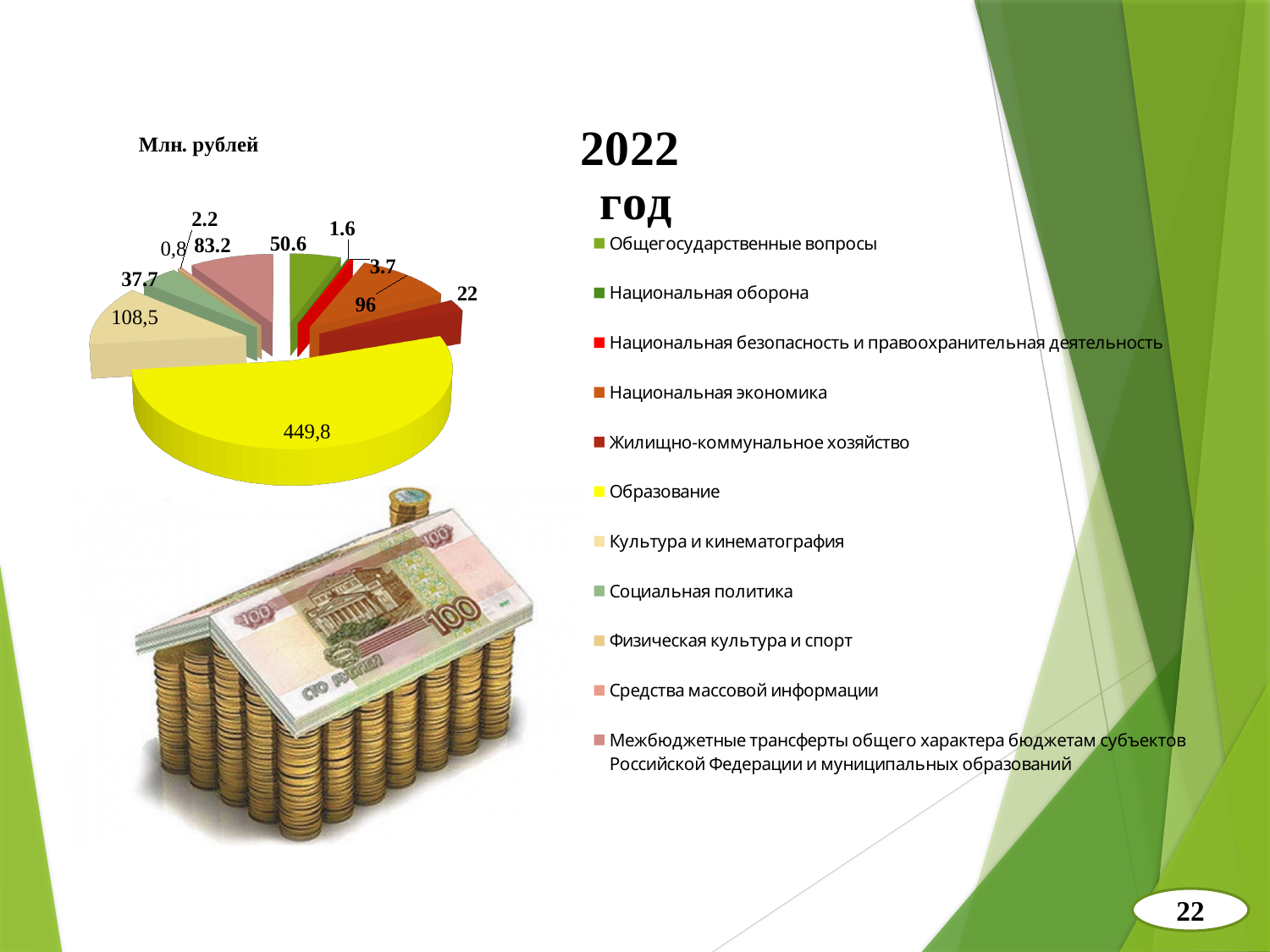
What value is shown for the Культура и кинематография slice? 108,5 Which is larger: the Национальная экономика slice or the Межбюджетные трансферты slice? Национальная экономика Which category has the smallest slice of the pie? Физическая культура и спорт Which year does the chart refer to? 2022 Which category has the largest slice of the pie? Образование How many categories does the legend list? 11 What is the difference between the Образование value and the Культура и кинематография value? 341,3 What kind of chart is shown on the slide? pie chart What value is shown for the Образование slice? 449,8 What value is shown for the Национальная экономика slice? 96 In what units are the chart values given? Млн. рублей What value is shown for the Общегосударственные вопросы slice? 50.6